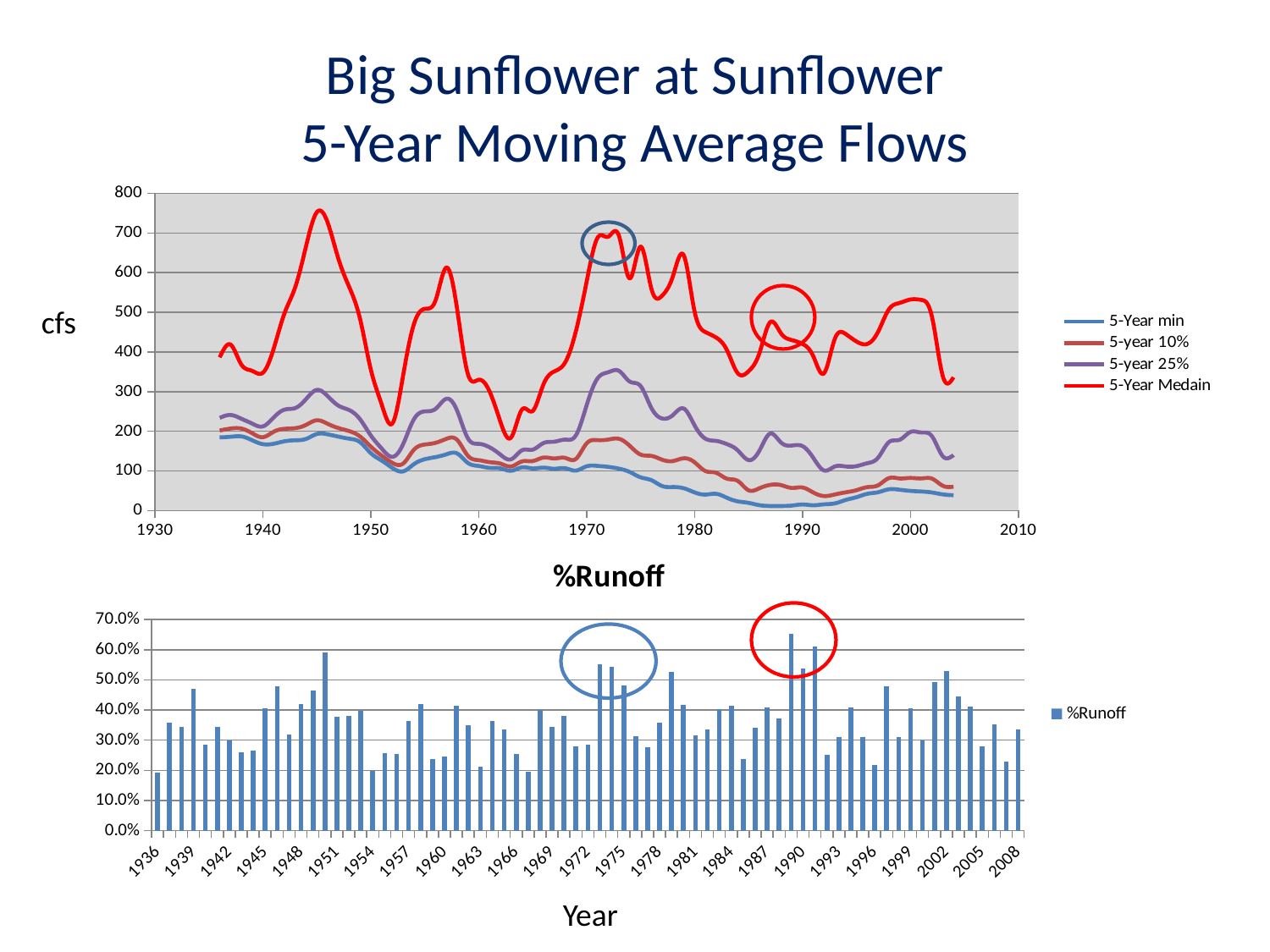
In the top chart, is the 5-Year min value around 1990 greater or less than 100? less What is the label on the vertical axis of the top chart? cfs In the top chart, is the 5-year 25% value around 1972 greater or less than 300? greater In the top chart, which series has the lowest values throughout the period? 5-Year min In the top chart, does the 5-Year min series generally rise or fall from 1936 to 2004? fall How many series does the legend of the top chart list? 4 How many series does the legend of the bottom '%Runoff' chart list? 1 What kind of chart is the top chart, 'Big Sunflower at Sunflower 5-Year Moving Average Flows'? line chart What kind of chart is the bottom chart, '%Runoff'? bar chart In the bottom '%Runoff' chart, is the tallest bar greater or less than 60.0%? greater In the top chart, which series has the highest values throughout the period? 5-Year Medain